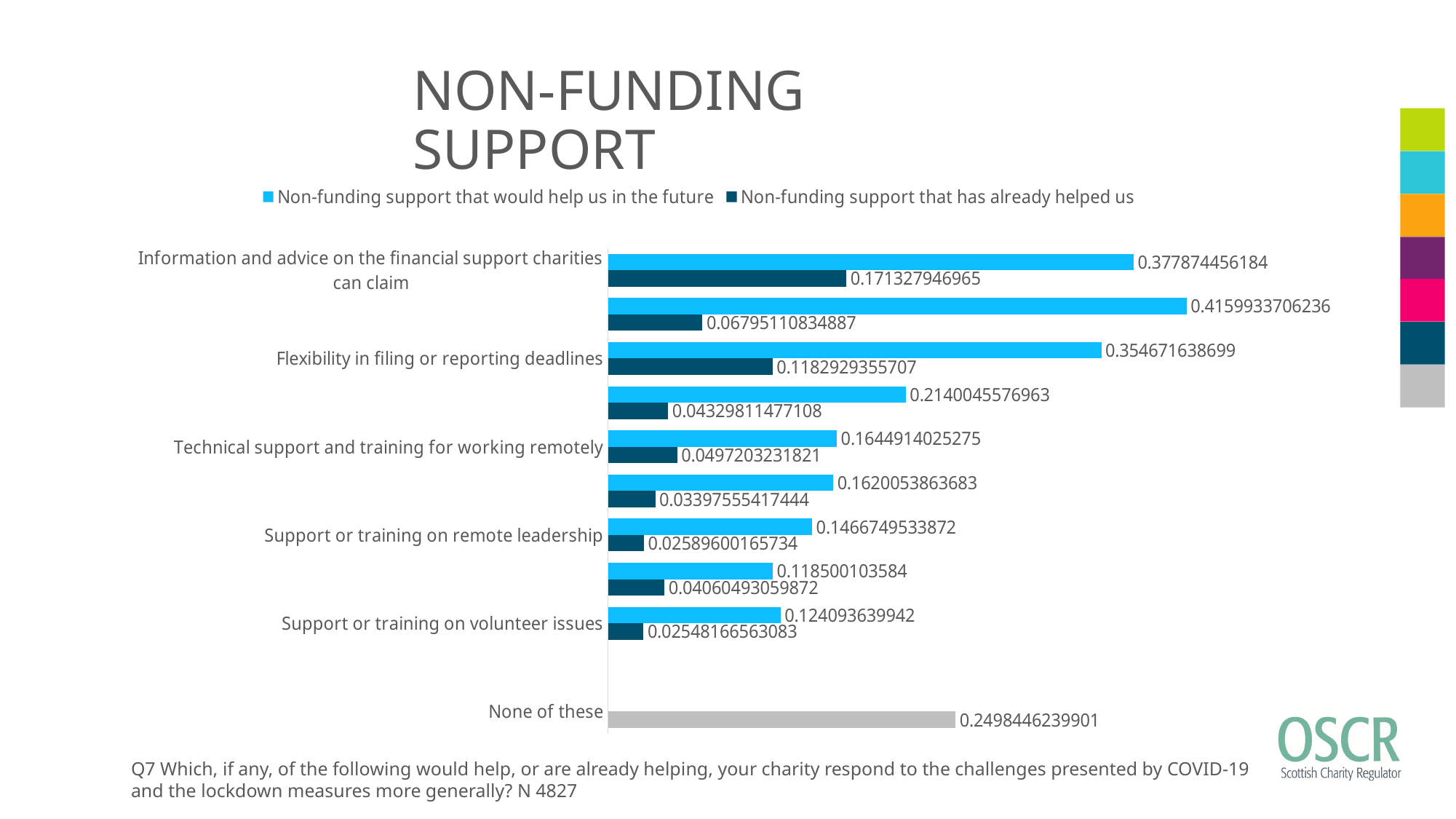
Which is larger for 'Non-funding support that would help us in the future': 'Flexibility in filing or reporting deadlines' or 'Technical support and training for working remotely'? Flexibility in filing or reporting deadlines What is the value of 'Non-funding support that would help us in the future' for 'Flexibility in filing or reporting deadlines'? 0.354671638699 What is the value of 'Non-funding support that has already helped us' for 'Information and advice on the financial support charities can claim'? 0.171327946965 What is the title of the chart on the slide? NON-FUNDING SUPPORT What is the value of 'Non-funding support that would help us in the future' for 'Support or training on volunteer issues'? 0.124093639942 What is the value of 'Non-funding support that would help us in the future' for 'Information and advice on the financial support charities can claim'? 0.377874456184 What is the value of 'Non-funding support that has already helped us' for 'Technical support and training for working remotely'? 0.0497203231821 What type of chart is shown on the slide? Bar chart How many series does the legend list? 2 Which category has the highest value for 'Non-funding support that has already helped us'? Information and advice on the financial support charities can claim What is the difference between the 'would help us in the future' and 'has already helped us' values for 'Information and advice on the financial support charities can claim'? 0.206546509219 What is the value shown for 'None of these'? 0.2498446239901